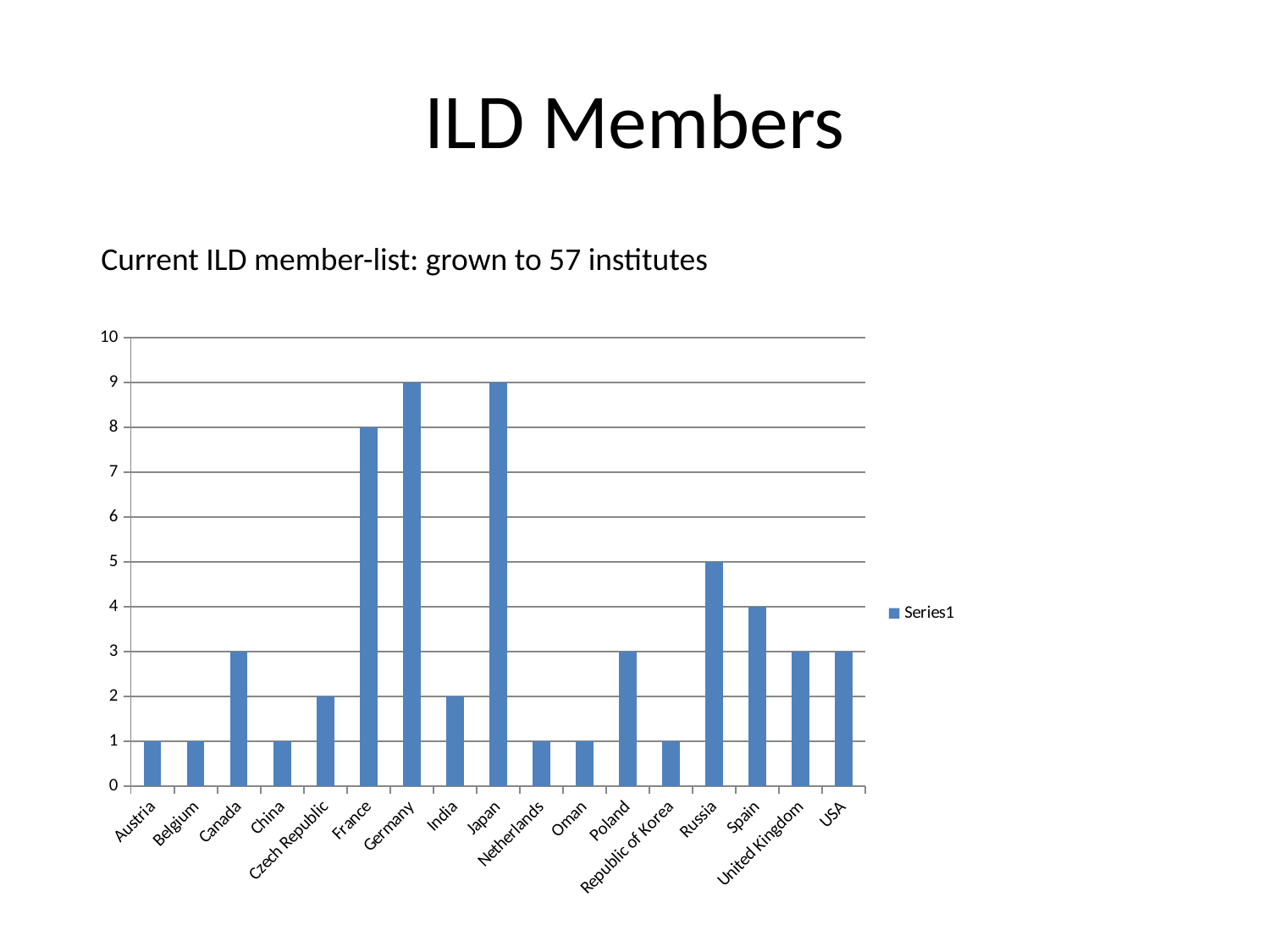
What is the value for Spain? 4 What is the value for Czech Republic? 2 Which is larger, the value for India or the value for Poland? Poland What is the difference between the values for Germany and France? 1 What is the value for France? 8 How many categories are shown on the x axis? 17 What kind of chart is shown on the slide? Bar chart How many series does the legend list? 1 Which is larger, the value for Spain or the value for United Kingdom? Spain What is the value for Russia? 5 What is the name of the series shown in the legend? Series1 What is the difference between the values for Russia and Canada? 2